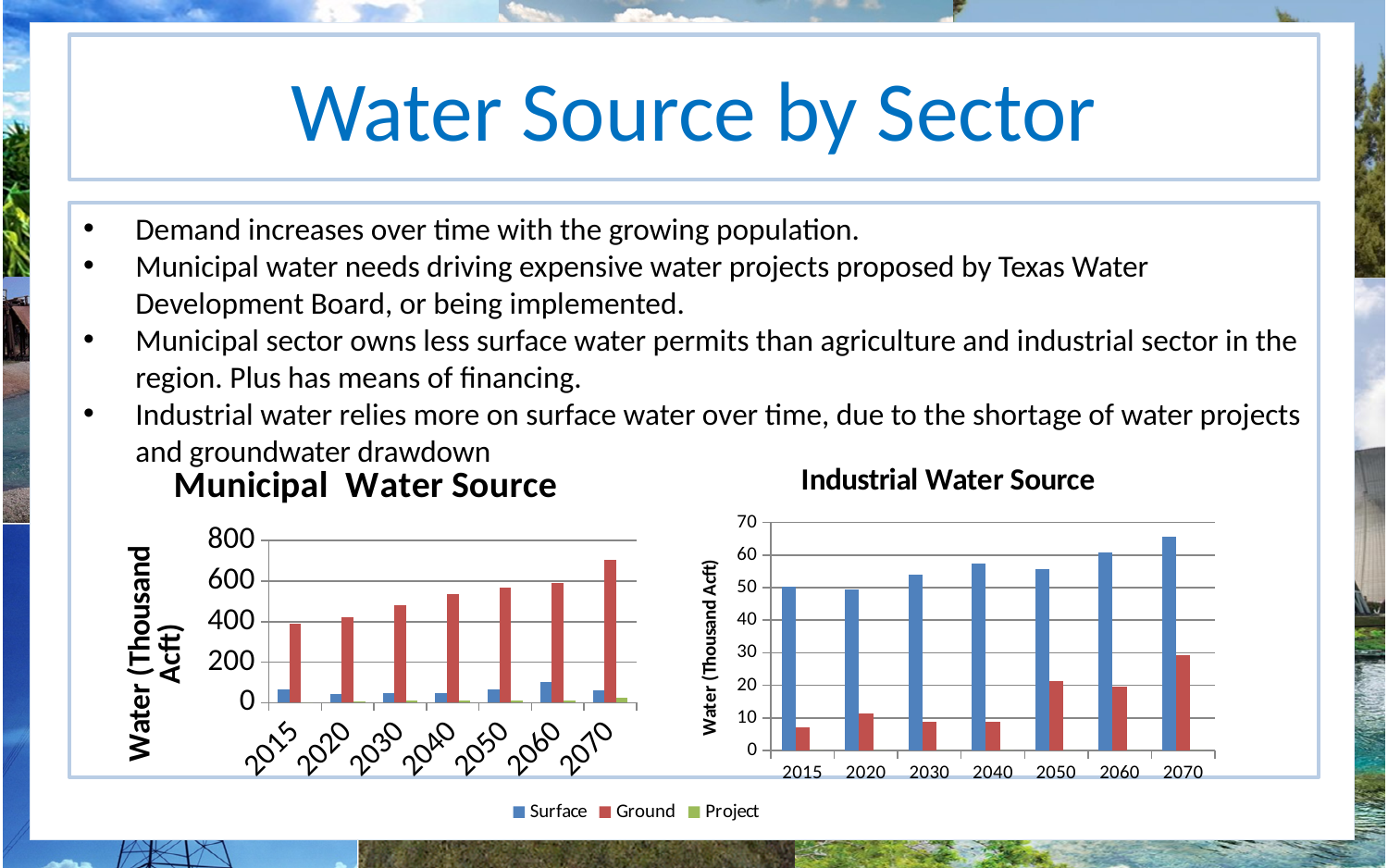
In the Industrial Water Source chart, is the Ground value for 2015 greater or less than 10? less In the Municipal Water Source chart, is the Ground value for 2070 greater or less than 600? greater In the Industrial Water Source chart, is the Surface value for 2070 greater or less than 60? greater How many years are shown on the x axis of the Industrial Water Source chart? 7 What type of chart is the Municipal Water Source chart? bar chart How many series does the legend at the bottom of the slide list? 3 In the Municipal Water Source chart, which year has the highest Ground value? 2070 In the Municipal Water Source chart, does the Ground series rise or fall from 2015 to 2070? rise What is the y-axis label of the Industrial Water Source chart? Water (Thousand Acft) In the Industrial Water Source chart, which year has the lowest Ground value? 2015 In the Industrial Water Source chart, which is larger in 2070, Surface or Ground? Surface